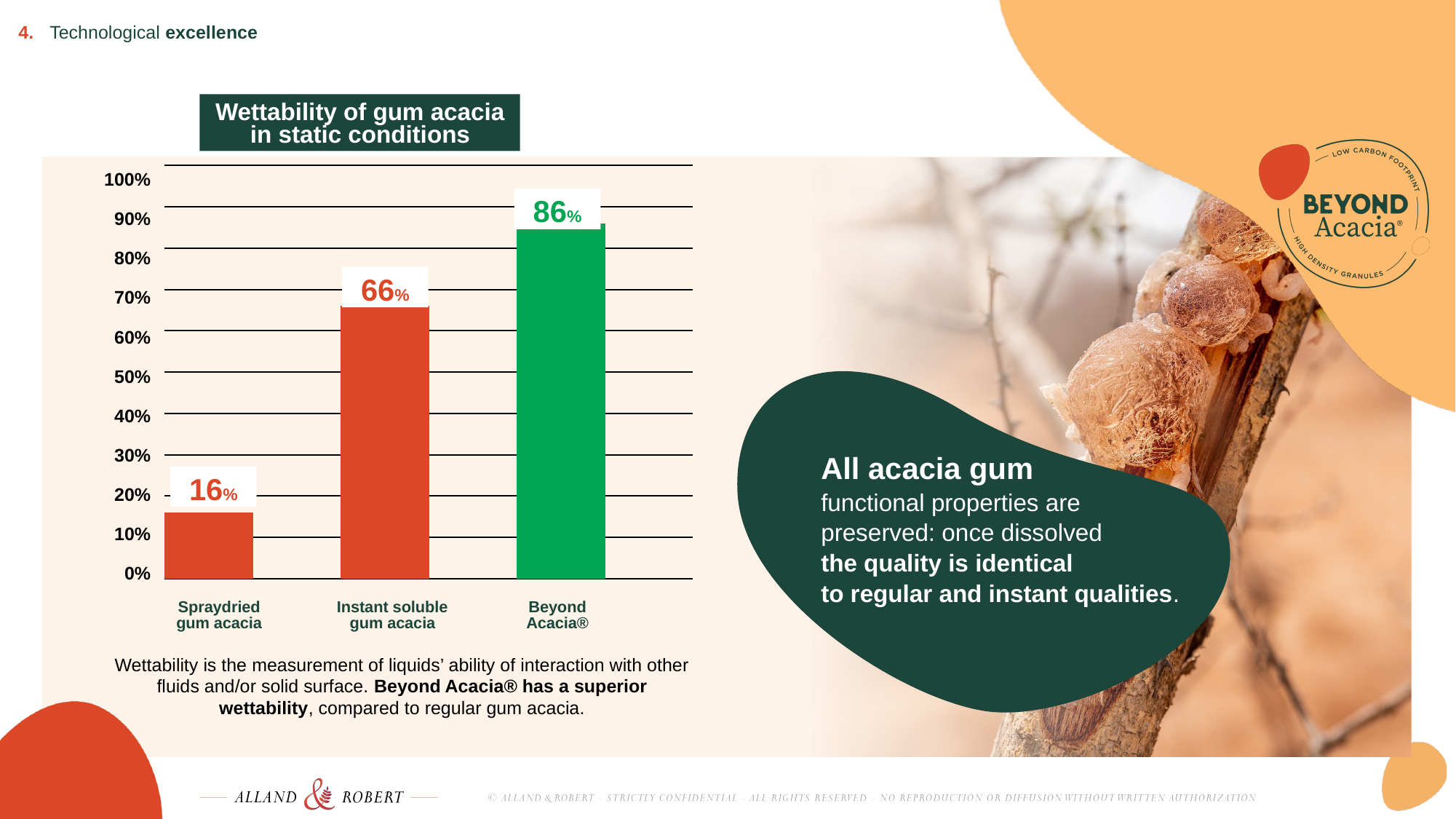
How many categories are shown in the chart? 3 Which category has the highest wettability? Beyond Acacia® What is the wettability value for Beyond Acacia®? 86% What kind of chart is shown on the slide? Bar chart What is the wettability value for Spraydried gum acacia? 16% What is the title of the chart? Wettability of gum acacia in static conditions Which category has the lowest wettability? Spraydried gum acacia Which has a higher wettability, Spraydried gum acacia or Instant soluble gum acacia? Instant soluble gum acacia Is the value for Beyond Acacia® greater or less than 80%? greater What is the difference in wettability between Beyond Acacia® and Instant soluble gum acacia? 20% What is the difference in wettability between Instant soluble gum acacia and Spraydried gum acacia? 50% What is the wettability value for Instant soluble gum acacia? 66%